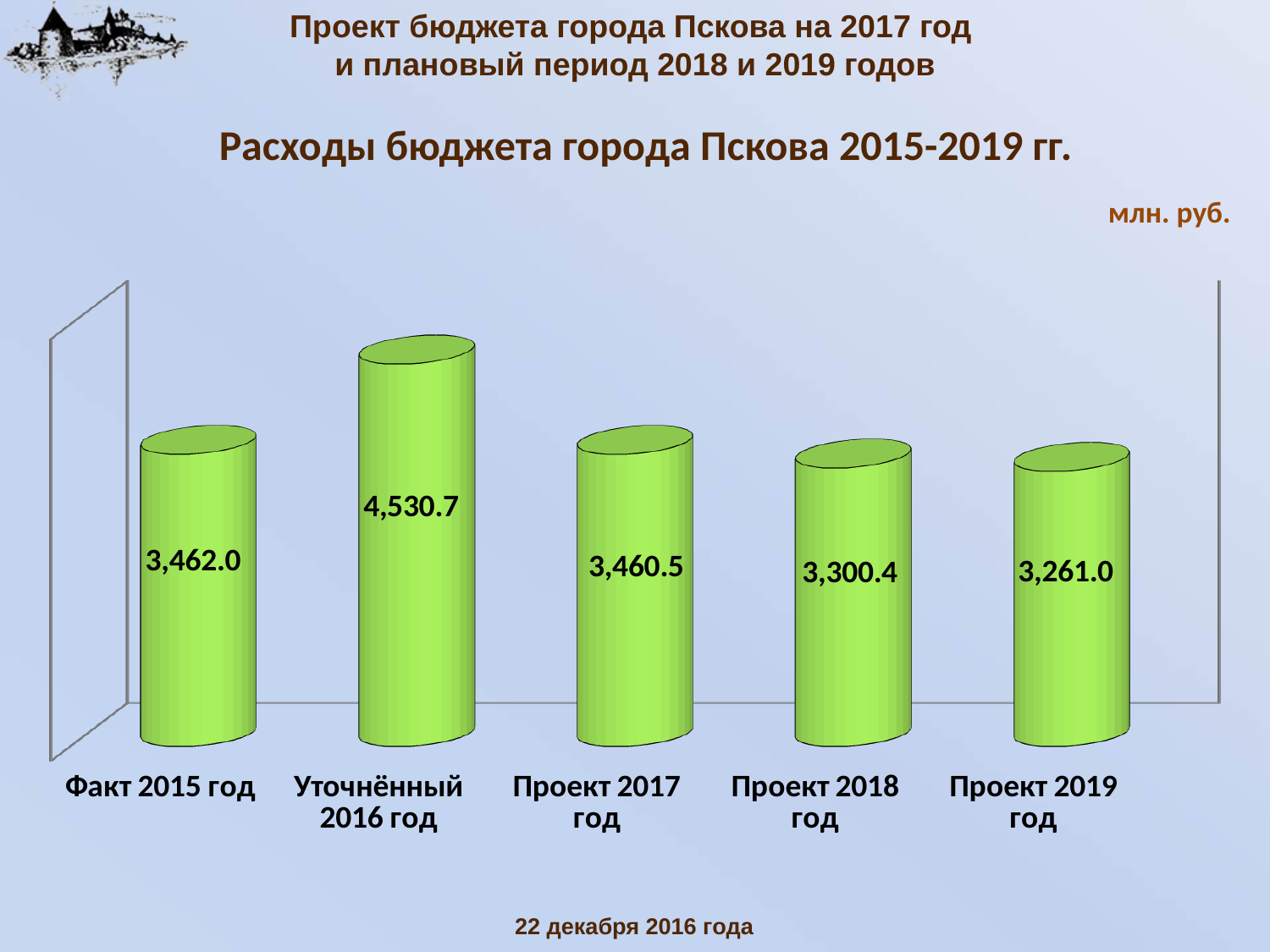
What kind of chart is shown on the slide? Bar chart What is the difference between the values for Уточнённый 2016 год and Факт 2015 год? 1,068.7 What is the value for Проект 2019 год? 3,261.0 Which category has the highest value? Уточнённый 2016 год What is the value for Уточнённый 2016 год? 4,530.7 Which is larger, the value for Уточнённый 2016 год or the value for Проект 2018 год? Уточнённый 2016 год What is the difference between the values for Проект 2017 год and Проект 2018 год? 160.1 What is the value for Факт 2015 год? 3,462.0 From Уточнённый 2016 год to Проект 2019 год, do the values rise or fall? Fall Which category has the lowest value? Проект 2019 год How many categories are shown in the chart? 5 What is the value for Проект 2017 год? 3,460.5